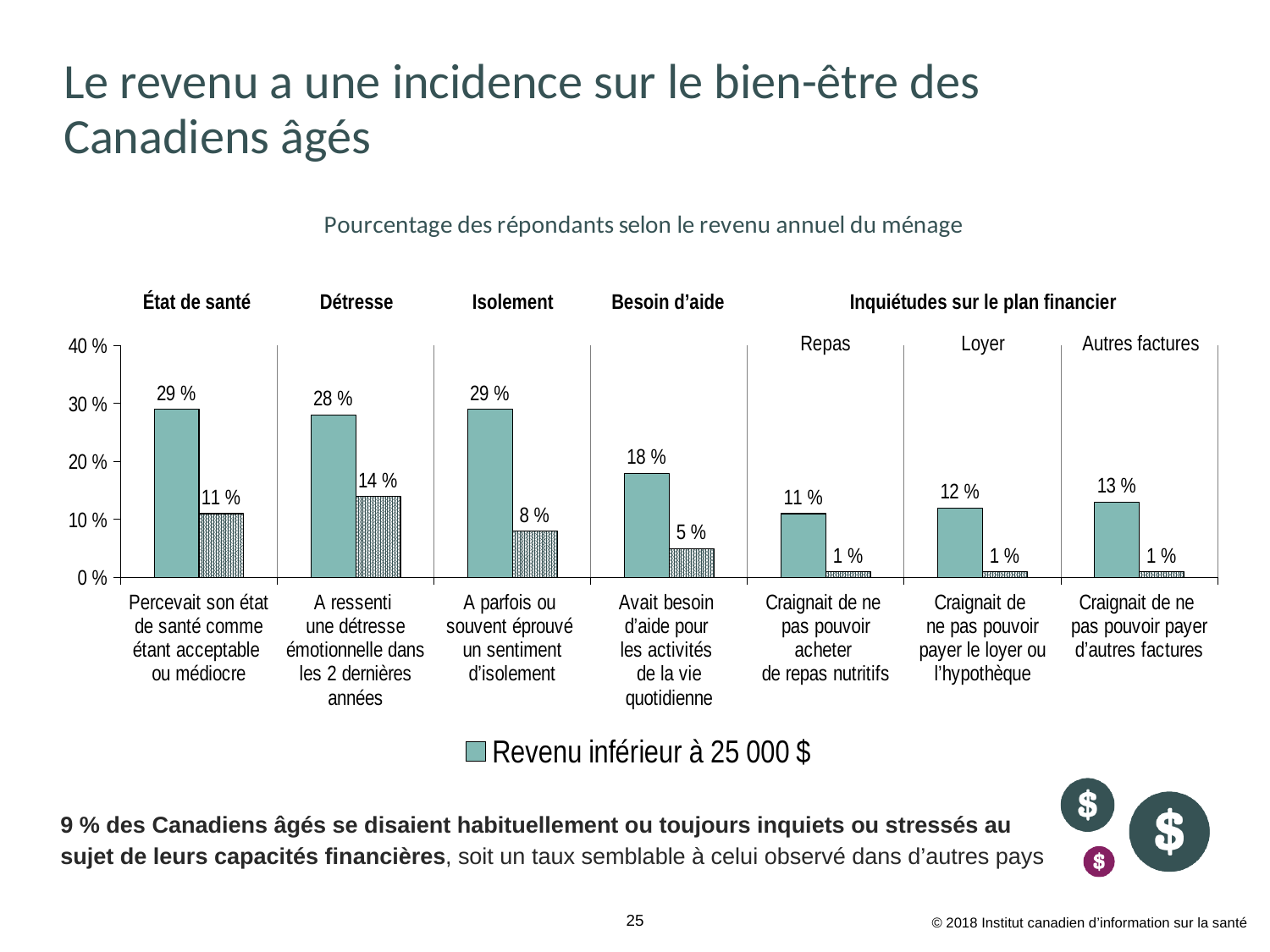
Is the 'Revenu inférieur à 25 000 $' value for 'A parfois ou souvent éprouvé un sentiment d'isolement' greater or less than 20 %? greater How many categories are shown along the x axis of the chart? 7 What is the value for 'Revenu inférieur à 25 000 $' in the category 'Avait besoin d'aide pour les activités de la vie quotidienne'? 18 % What is the value of the patterned (second) bar in the category 'A parfois ou souvent éprouvé un sentiment d'isolement'? 8 % What is the value for 'Revenu inférieur à 25 000 $' in the category 'Craignait de ne pas pouvoir payer le loyer ou l'hypothèque'? 12 % What is the chart's title? Pourcentage des répondants selon le revenu annuel du ménage Which is larger: the 'Revenu inférieur à 25 000 $' value for 'Craignait de ne pas pouvoir payer d'autres factures' or for 'Craignait de ne pas pouvoir acheter de repas nutritifs'? Craignait de ne pas pouvoir payer d'autres factures What is the difference between the two bars in the category 'Avait besoin d'aide pour les activités de la vie quotidienne'? 13 % What is the difference between the two bars in the category 'Percevait son état de santé comme étant acceptable ou médiocre'? 18 % What is the value for 'Revenu inférieur à 25 000 $' in the category 'A ressenti une détresse émotionnelle dans les 2 dernières années'? 28 % What kind of chart is shown on the slide? bar chart Which category has the lowest value for 'Revenu inférieur à 25 000 $'? Craignait de ne pas pouvoir acheter de repas nutritifs